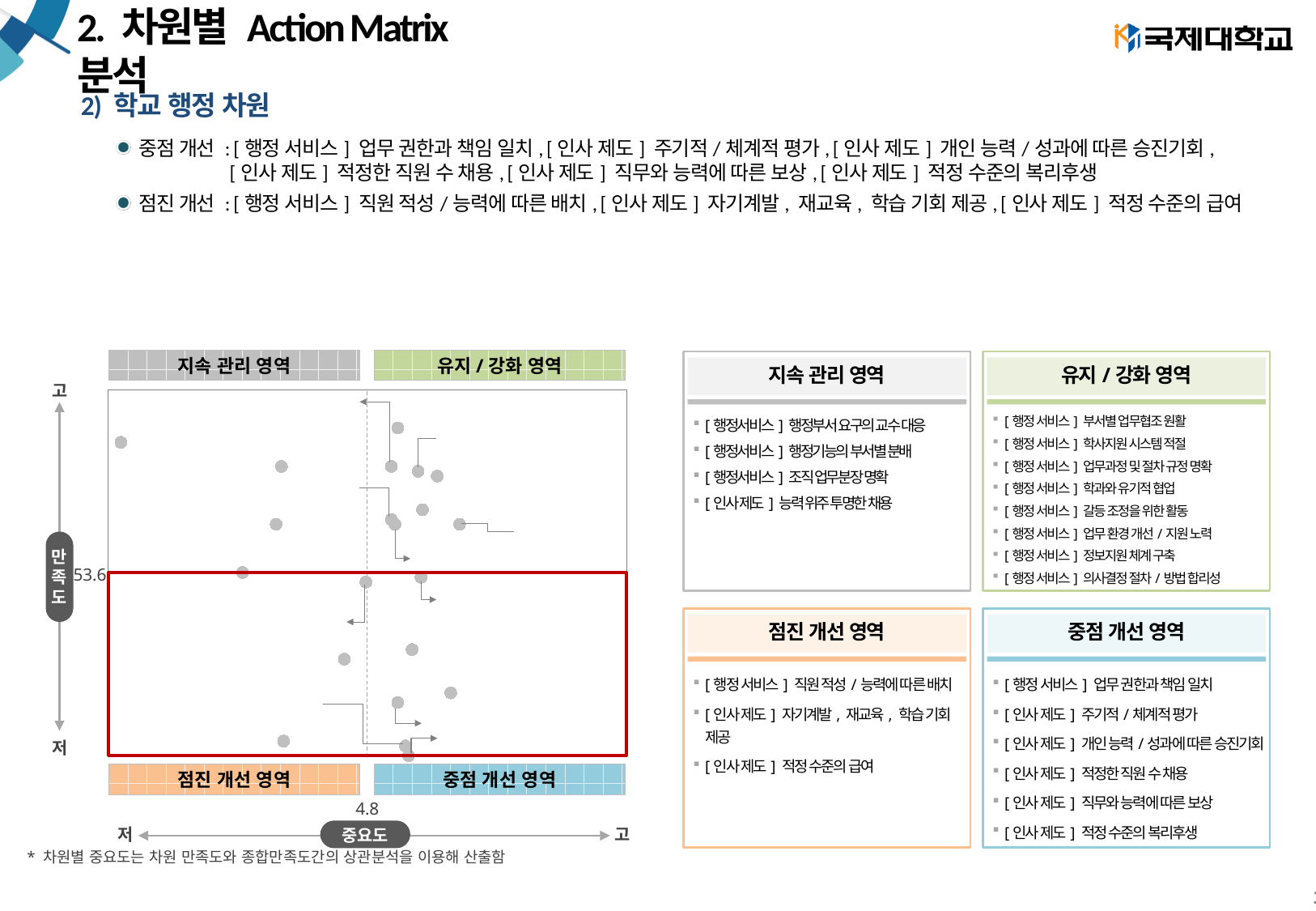
What is the label of the vertical axis of the Action Matrix chart? 만족도 What kind of chart is shown on the left of the slide? scatter chart What value marks the vertical dividing line on the 중요도 (x) axis of the Action Matrix? 4.8 What value marks the horizontal dividing line on the 만족도 (y) axis of the Action Matrix? 53.6 How many quadrant areas are labelled around the Action Matrix chart? 4 Which quadrant of the Action Matrix is outlined with a red box? 점진 개선 영역 and 중점 개선 영역 (the whole bottom half)